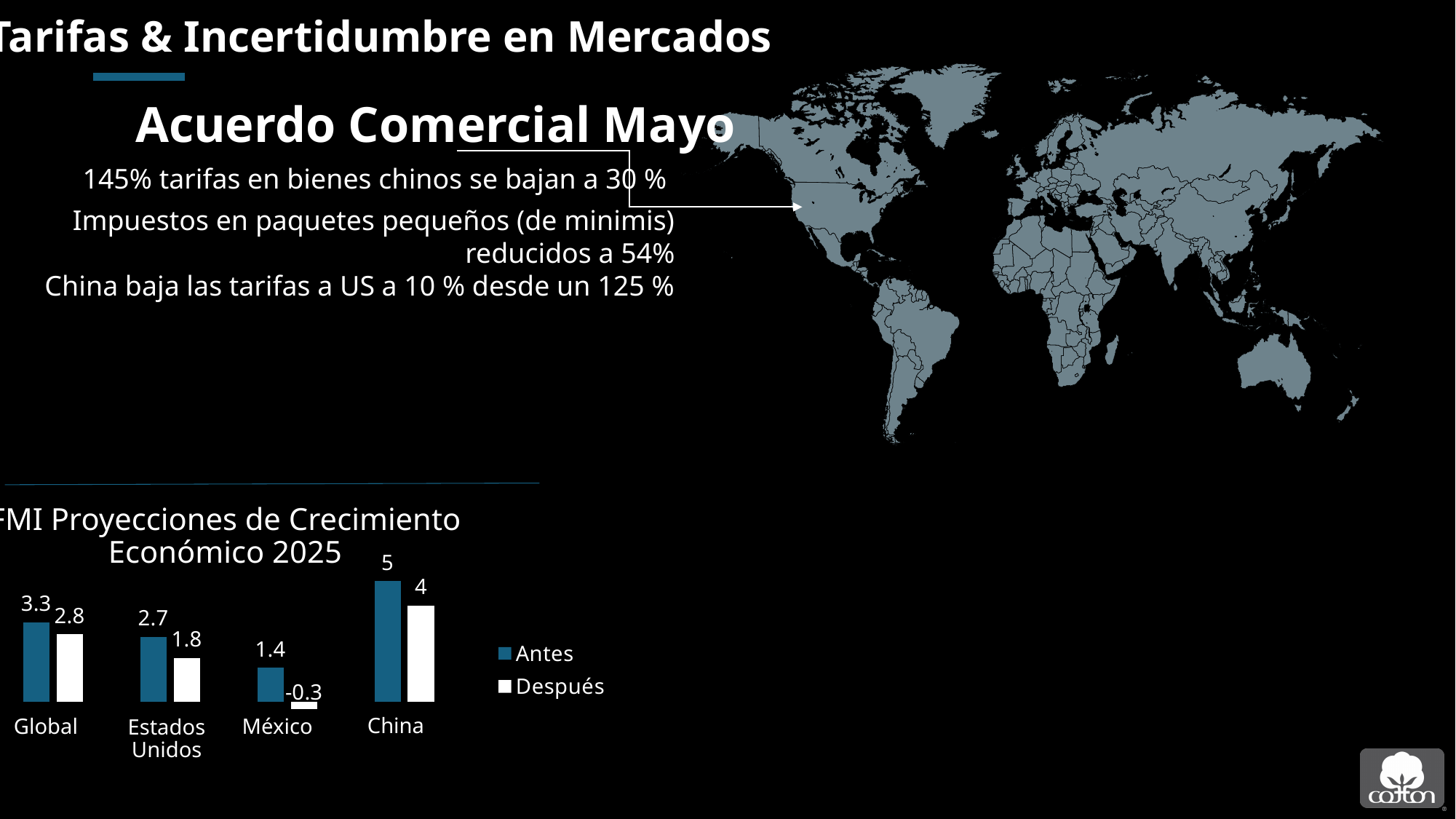
What is the 'Antes' value for Estados Unidos? 2.7 What is the 'Después' value for Global? 2.8 What is the difference between the 'Antes' and 'Después' values for China? 1 Which category has the lowest 'Después' value? México What kind of chart is the FMI Proyecciones de Crecimiento Económico 2025 chart? Bar chart Which category has the highest 'Antes' value? China What is the 'Antes' value for China in the FMI Proyecciones de Crecimiento Económico 2025 chart? 5 What is the 'Después' value for México? -0.3 What is the difference between the 'Antes' and 'Después' values for Estados Unidos? 0.9 Which is larger: the 'Después' value for Global or the 'Después' value for Estados Unidos? Global How many categories are shown on the x axis of the chart? 4 How many series does the legend list? 2